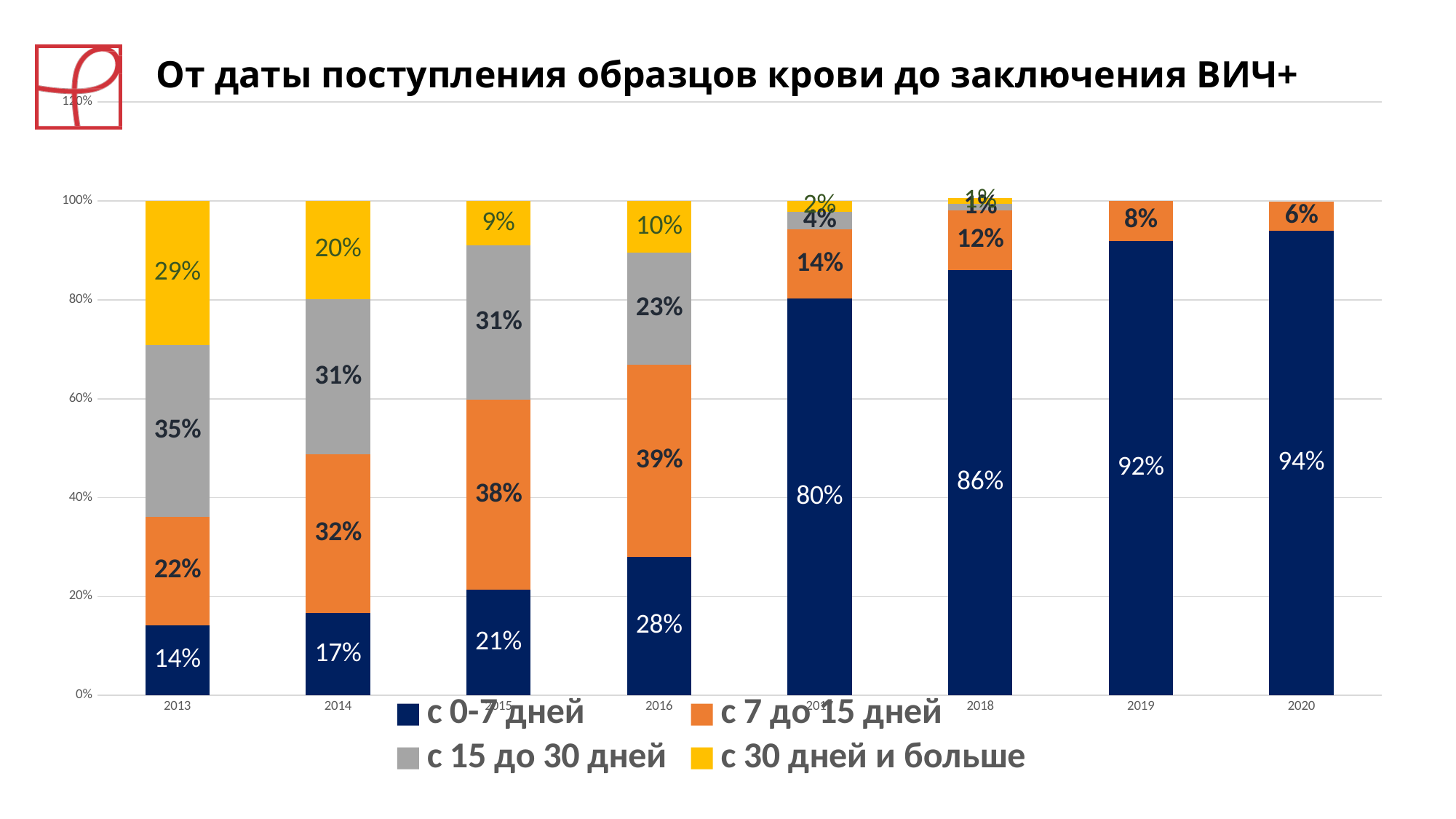
In which year is the "с 0-7 дней" share lowest? 2013 Which is larger in 2015: "с 7 до 15 дней" or "с 15 до 30 дней"? с 7 до 15 дней What is the difference between the "с 0-7 дней" values for 2020 and 2013? 80% How many years are shown on the x axis? 8 How many series does the legend list? 4 What is the value for "с 15 до 30 дней" in 2017? 4% In which year is the "с 0-7 дней" share highest? 2020 What is the value for "с 30 дней и больше" in 2014? 20% What is the value for "с 0-7 дней" in 2013? 14% What kind of chart is shown on the slide? Stacked bar chart Does the "с 0-7 дней" share rise or fall from 2013 to 2020? Rise What is the value for "с 7 до 15 дней" in 2016? 39%